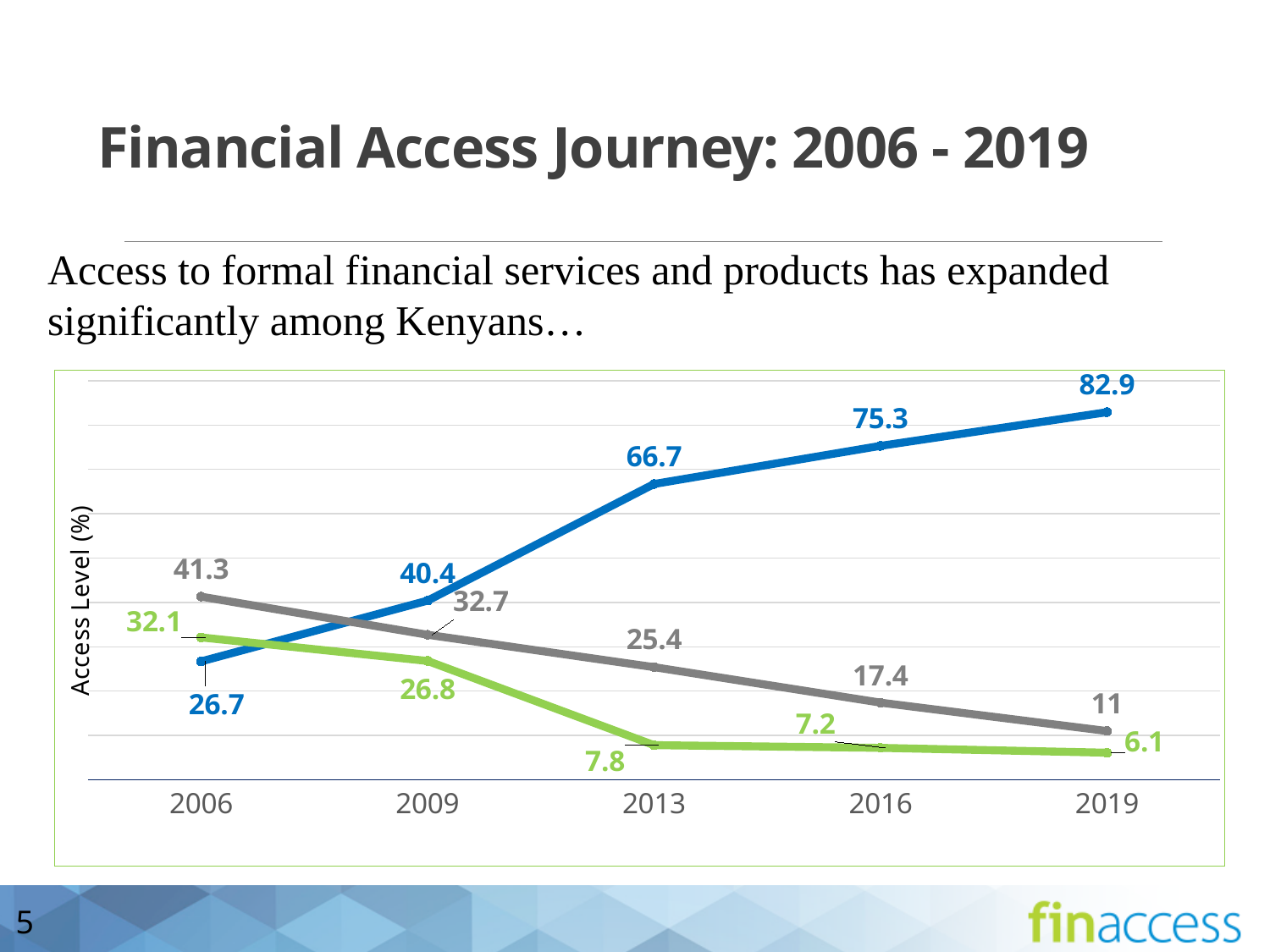
What is the difference between the blue line's values in 2019 and 2006? 56.2 Does the grey line rise or fall from 2006 to 2019? fall How many years are shown on the x axis? 5 What is the value of the blue line in 2006? 26.7 What kind of chart is shown on the slide? line chart In which year does the blue line reach its highest value? 2019 What is the value of the blue line in 2019? 82.9 In 2009, which line has the higher value, the blue line or the grey line? the blue line How many lines are plotted on the chart? 3 What is the value of the green line in 2013? 7.8 What is the value of the grey line in 2006? 41.3 In which year does the grey line have its lowest value? 2019